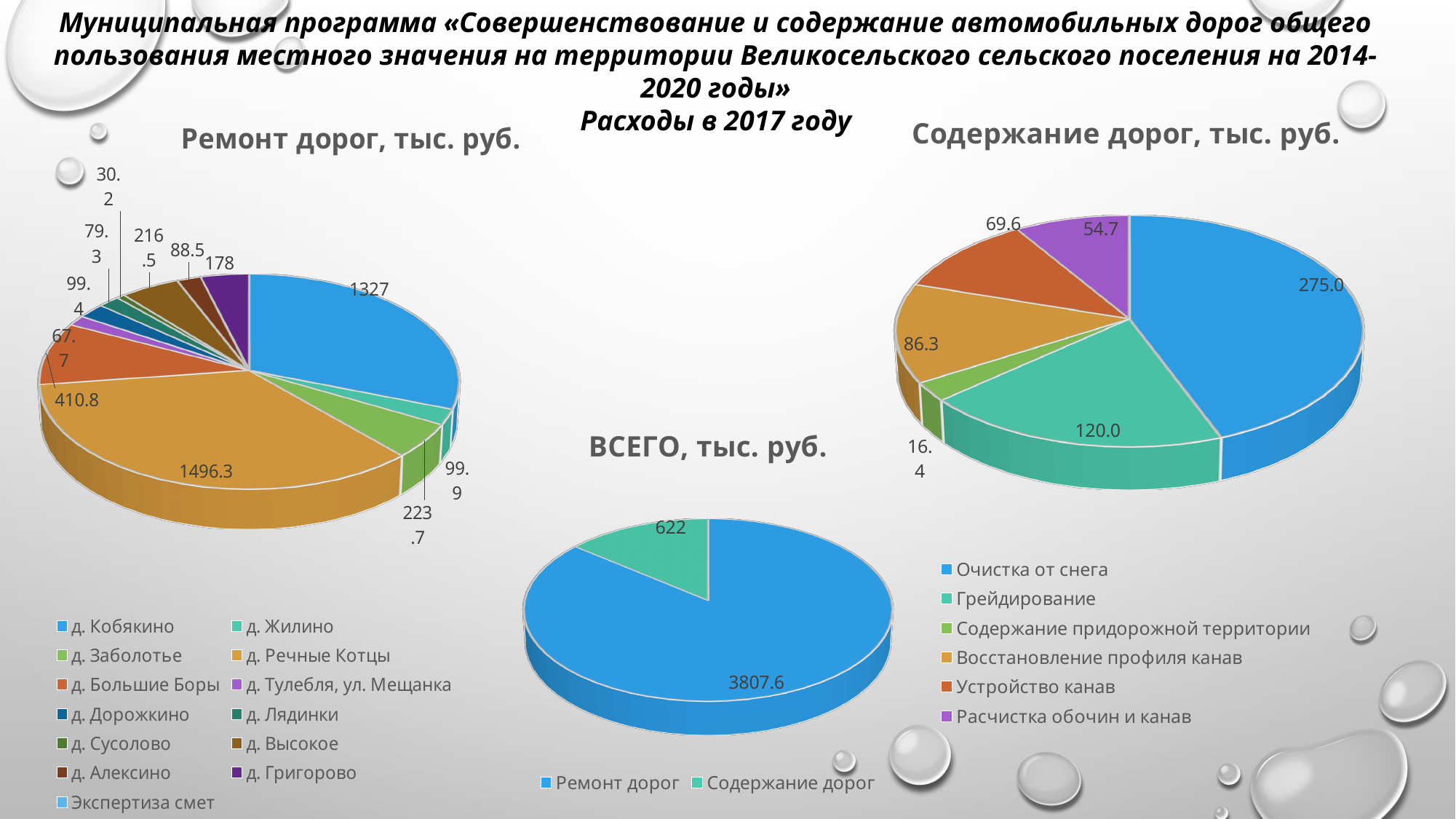
What kind of chart is the one titled "ВСЕГО, тыс. руб."? Pie chart In the chart titled "ВСЕГО, тыс. руб.", what is the total of the two slices? 4429.6 In the chart titled "Ремонт дорог, тыс. руб.", what is the difference between the values for д. Речные Котцы and д. Кобякино? 169.3 In the chart titled "Ремонт дорог, тыс. руб.", which category has the largest slice? д. Речные Котцы In the chart titled "Ремонт дорог, тыс. руб.", what is the value for д. Большие Боры? 410.8 In the chart titled "Ремонт дорог, тыс. руб.", what is the value for д. Речные Котцы? 1496.3 In the chart titled "Ремонт дорог, тыс. руб.", how many entries does the legend list? 13 In the chart titled "Содержание дорог, тыс. руб.", what is the difference between Очистка от снега and Грейдирование? 155.0 In the chart titled "Содержание дорог, тыс. руб.", which is larger: Грейдирование or Восстановление профиля канав? Грейдирование In the chart titled "Содержание дорог, тыс. руб.", what is the value for Очистка от снега? 275.0 In the chart titled "ВСЕГО, тыс. руб.", what is the value for Ремонт дорог? 3807.6 In the chart titled "Ремонт дорог, тыс. руб.", what is the value for д. Кобякино? 1327